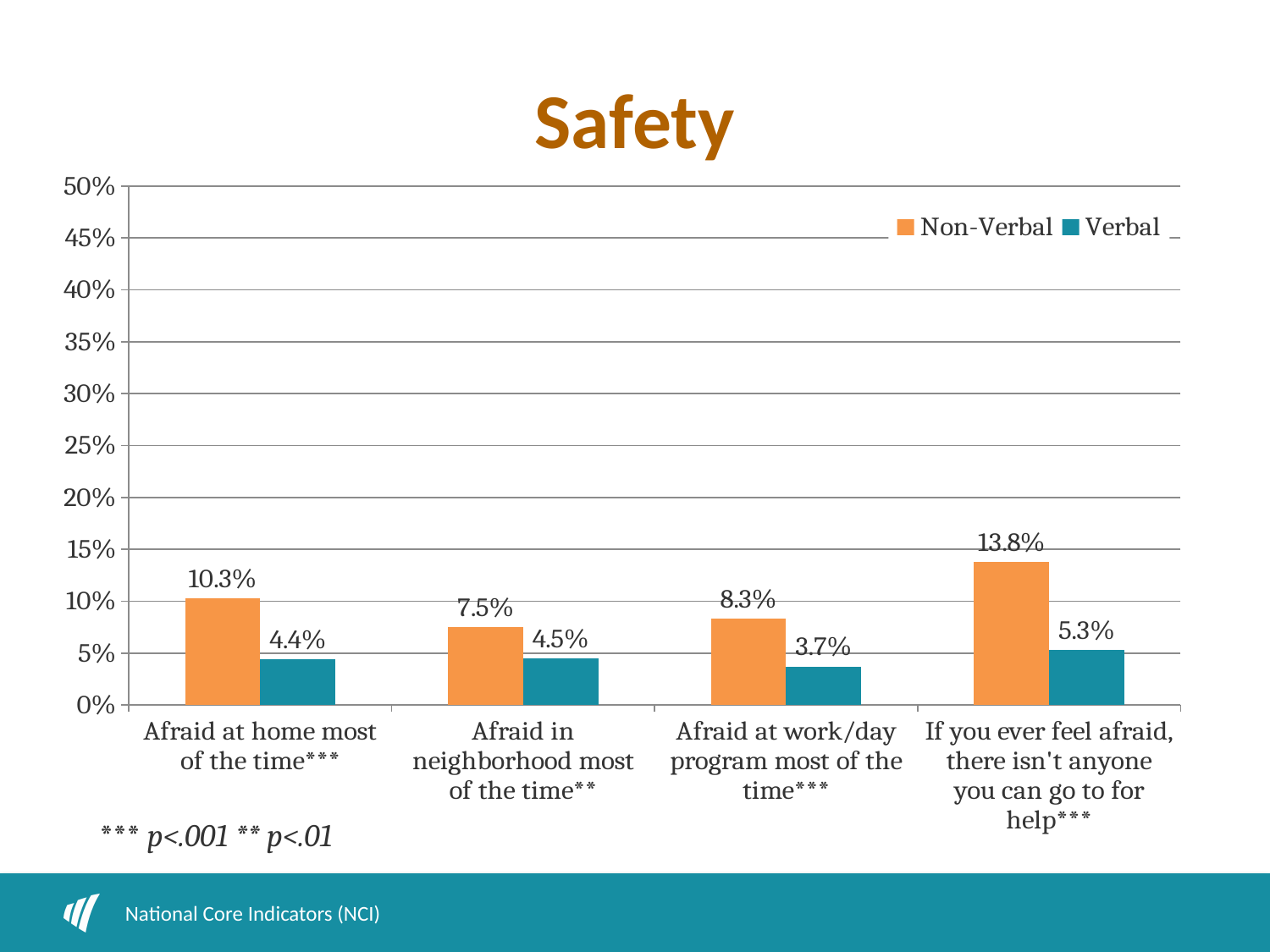
Which category has the lowest Verbal value? Afraid at work/day program most of the time What is the Non-Verbal value for "Afraid at home most of the time"? 10.3% How many categories are shown on the x axis? 4 How many series does the legend list? 2 What is the Verbal value for "Afraid at work/day program most of the time"? 3.7% What is the Non-Verbal value for "If you ever feel afraid, there isn't anyone you can go to for help"? 13.8% Which category has the highest Non-Verbal value? If you ever feel afraid, there isn't anyone you can go to for help What kind of chart is shown on the slide? Bar chart Which is larger for "Afraid in neighborhood most of the time": the Non-Verbal value or the Verbal value? Non-Verbal Is the Non-Verbal value for "Afraid at work/day program most of the time" greater or less than 10%? less What is the title of the chart? Safety What is the difference between the Non-Verbal and Verbal values for "Afraid at home most of the time"? 5.9%